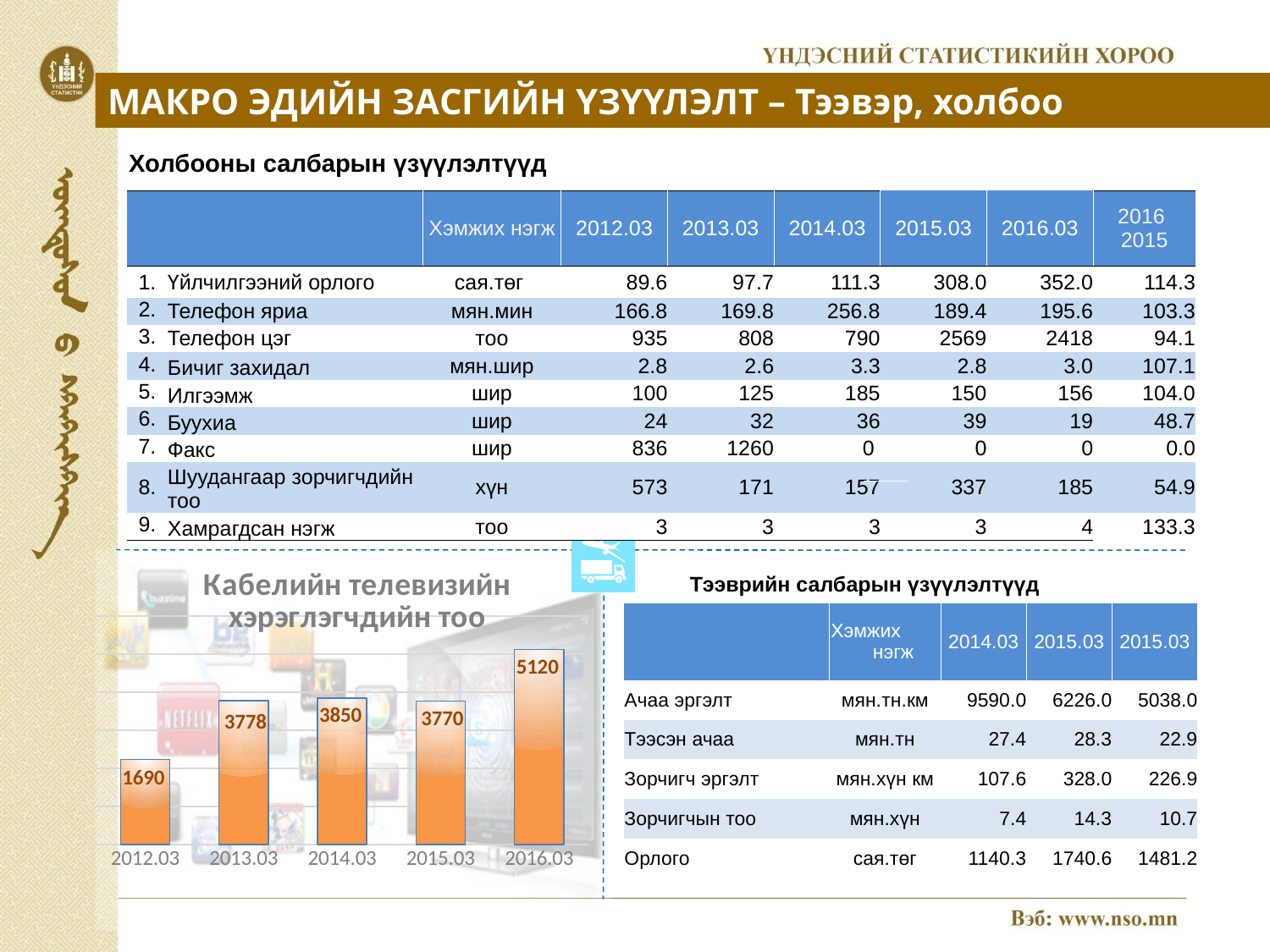
What kind of chart is 'Кабелийн телевизийн хэрэглэгчдийн тоо'? bar chart In the 'Кабелийн телевизийн хэрэглэгчдийн тоо' chart, what is the difference between the values for 2016.03 and 2015.03? 1350 What is the value for 2016.03 in the 'Кабелийн телевизийн хэрэглэгчдийн тоо' chart? 5120 Which period has the lowest value in the 'Кабелийн телевизийн хэрэглэгчдийн тоо' chart? 2012.03 How many periods are shown on the x axis of the 'Кабелийн телевизийн хэрэглэгчдийн тоо' chart? 5 What colour are the bars in the 'Кабелийн телевизийн хэрэглэгчдийн тоо' chart? orange What is the value for 2014.03 in the 'Кабелийн телевизийн хэрэглэгчдийн тоо' chart? 3850 Which period has the highest value in the 'Кабелийн телевизийн хэрэглэгчдийн тоо' chart? 2016.03 What is the value for 2012.03 in the 'Кабелийн телевизийн хэрэглэгчдийн тоо' chart? 1690 In the 'Кабелийн телевизийн хэрэглэгчдийн тоо' chart, which is larger: the value for 2014.03 or the value for 2015.03? 2014.03 In the 'Кабелийн телевизийн хэрэглэгчдийн тоо' chart, what is the difference between the values for 2013.03 and 2012.03? 2088 In the 'Кабелийн телевизийн хэрэглэгчдийн тоо' chart, does the value rise or fall from 2012.03 to 2013.03? rise